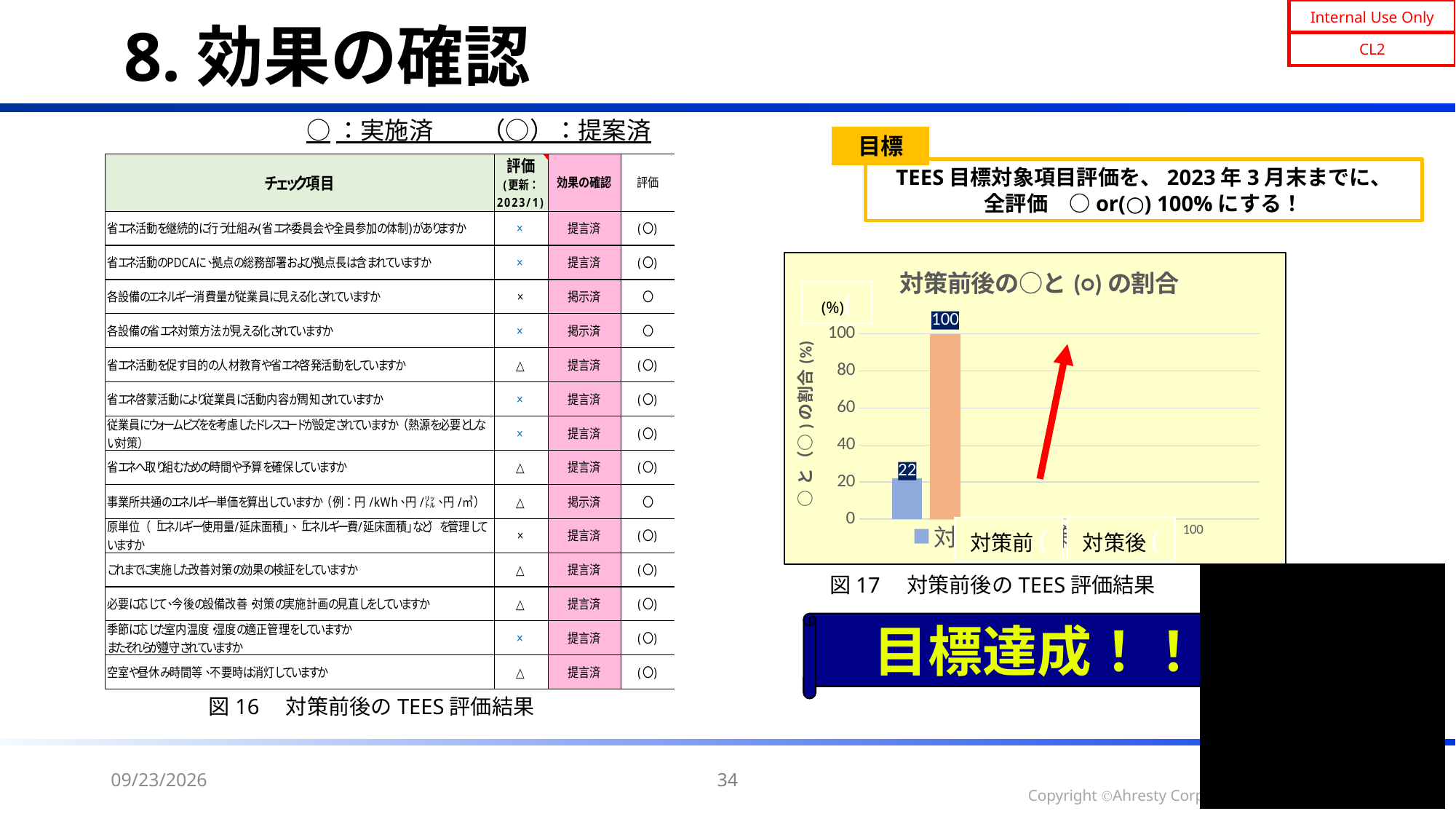
What is the difference between the 対策後 value and the 対策前 value in the chart? 78 What is the value for 対策後 in the chart? 100 What is the value for 対策前 in the chart? 22 Which category has the lowest value in the chart? 対策前 Is the value for 対策後 greater or less than 80? greater Which category has the higher value in the chart, 対策前 or 対策後? 対策後 What type of chart is shown in 図17 on the slide? bar chart Which category has the highest value in the chart? 対策後 What is the title of the chart in 図17? 対策前後の○と(○)の割合 Is the value for 対策前 greater or less than 40? less What is the maximum value shown on the chart's vertical axis? 100 How many bars are plotted in the chart? 2